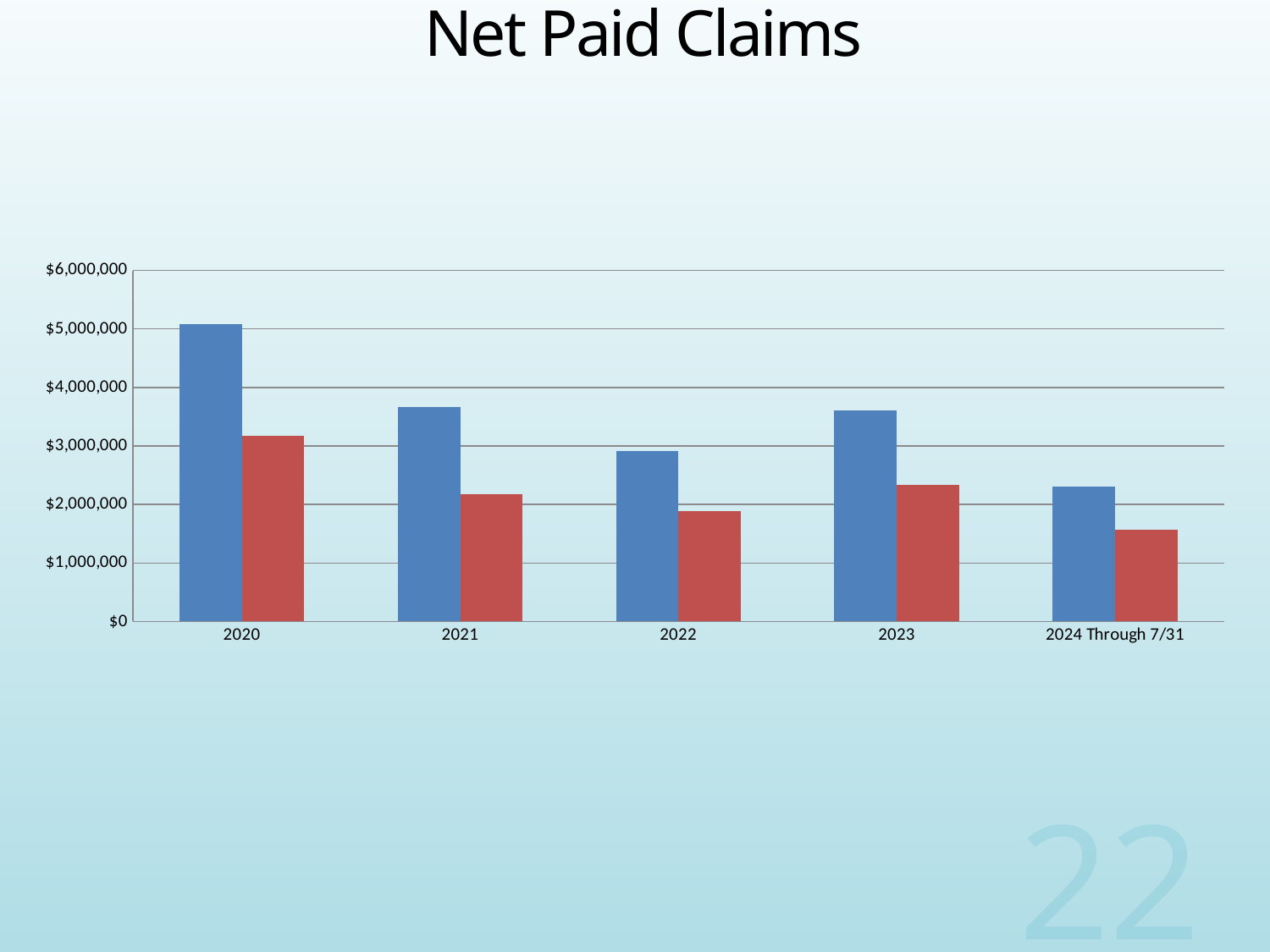
Which category has the lowest red bar? 2024 Through 7/31 Which is larger, the blue bar for 2023 or the blue bar for 2022? 2023 Which category has the highest blue bar? 2020 Is the red bar for 2022 greater or less than $2,000,000? less Is the blue bar for 2020 greater or less than $4,000,000? greater What kind of chart is shown on the slide? bar chart Which category has the highest red bar? 2020 What is the label of the last category on the x axis? 2024 Through 7/31 How many categories are shown on the x axis of the chart? 5 What is the title of the chart? Net Paid Claims Which category has the lowest blue bar? 2024 Through 7/31